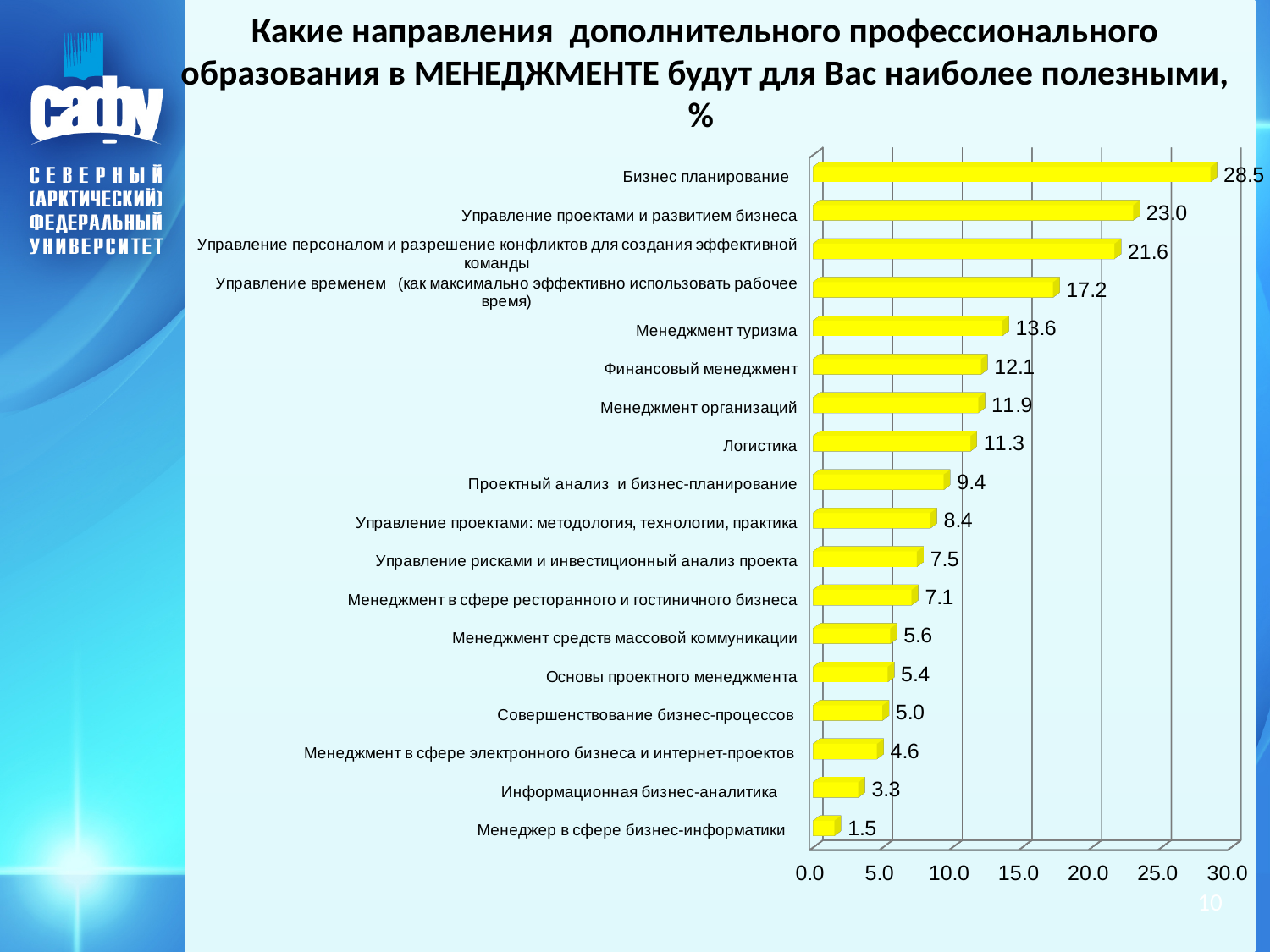
What is the value for Финансовый менеджмент? 12.1 How many categories are shown in the chart? 18 Which category has the highest value? Бизнес планирование What is the difference between the values for Бизнес планирование and Управление проектами и развитием бизнеса? 5.5 Is the value for Управление временем greater or less than 15.0? greater What is the value for Информационная бизнес-аналитика? 3.3 What colour are the bars in the chart? yellow Which is larger: the value for Менеджмент туризма or the value for Финансовый менеджмент? Менеджмент туризма What is the value for Логистика? 11.3 What is the value for Бизнес планирование? 28.5 Which category has the lowest value? Менеджер в сфере бизнес-информатики What kind of chart is shown on the slide? bar chart